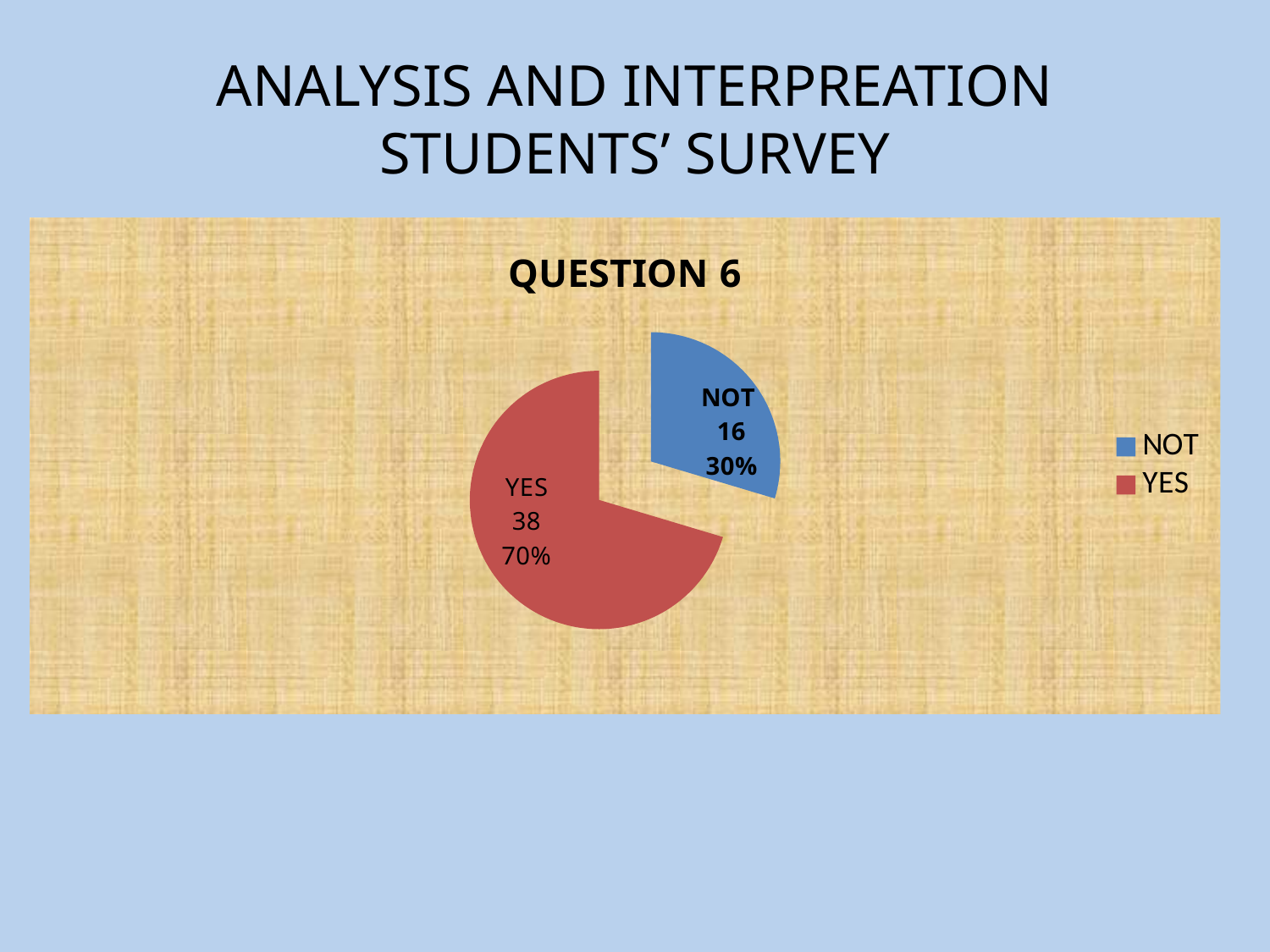
What is the title of the chart? QUESTION 6 Which slice is the smallest? NOT How many slices does the pie chart have? 2 What is the difference between the YES count and the NOT count? 22 What is the total of the YES and NOT counts? 54 What kind of chart is shown on the slide? pie chart How many entries does the legend list? 2 Which slice is the largest? YES What is the count for YES? 38 What share of the pie does YES represent? 70% What share of the pie does NOT represent? 30% What is the count for NOT? 16